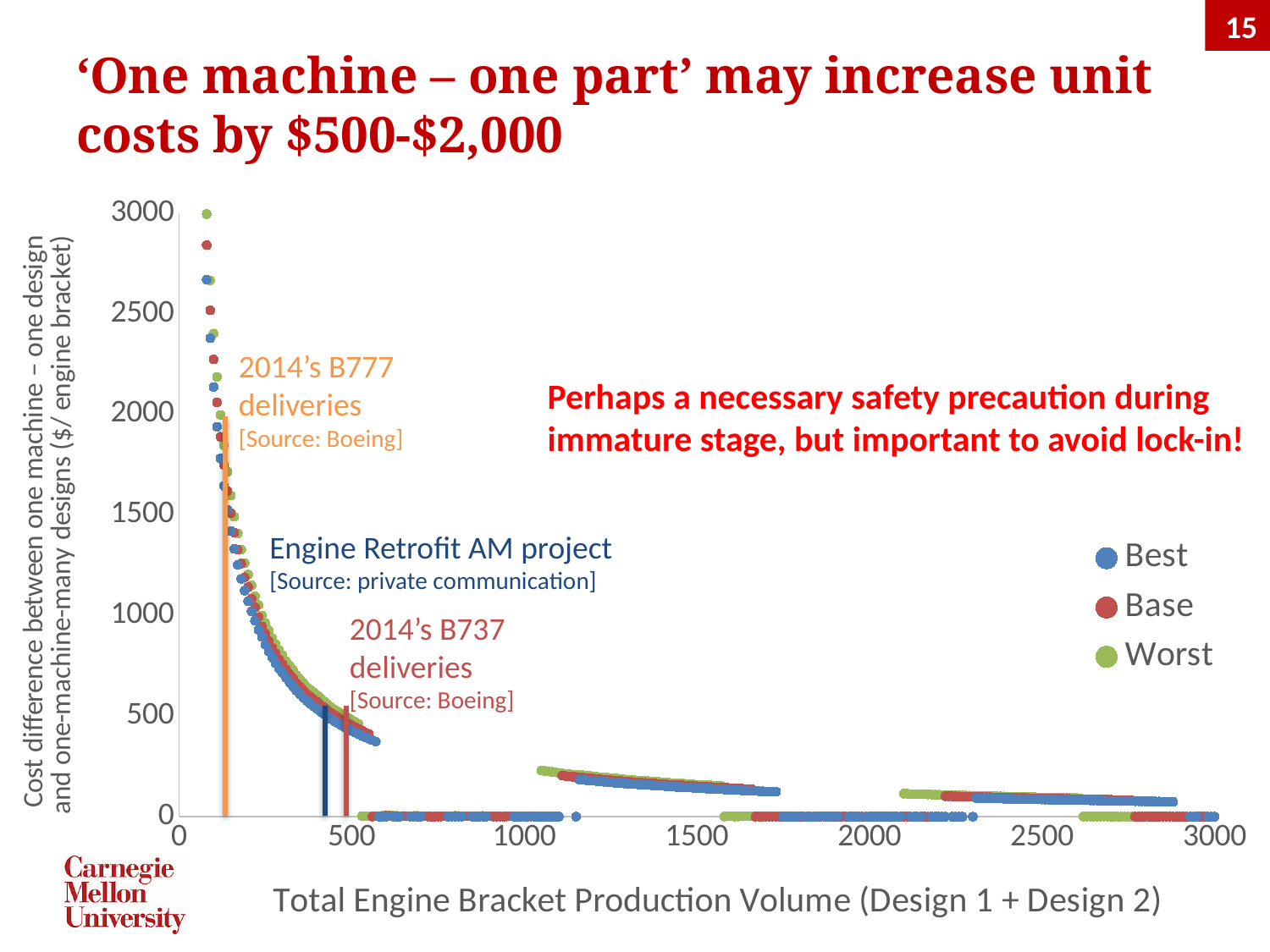
Which vertical marker line on the chart is at the lowest production volume: 2014's B777 deliveries, the Engine Retrofit AM project, or 2014's B737 deliveries? 2014's B777 deliveries Is the cost difference at a production volume of 2500 greater or less than 500? less What are the three series named in the chart legend? Best, Base, Worst What is the highest value shown on the chart's y axis? 3000 Do the plotted cost-difference values rise or fall as production volume increases along the x axis? fall How many series does the chart legend list? 3 What is the title of the chart's x axis? Total Engine Bracket Production Volume (Design 1 + Design 2) Is the cost difference at a production volume of 500 greater or less than 1000? less What is the highest value shown on the chart's x axis? 3000 Is the cost difference at a production volume of 200 greater or less than 1000? greater What kind of chart is shown on the slide? scatter chart